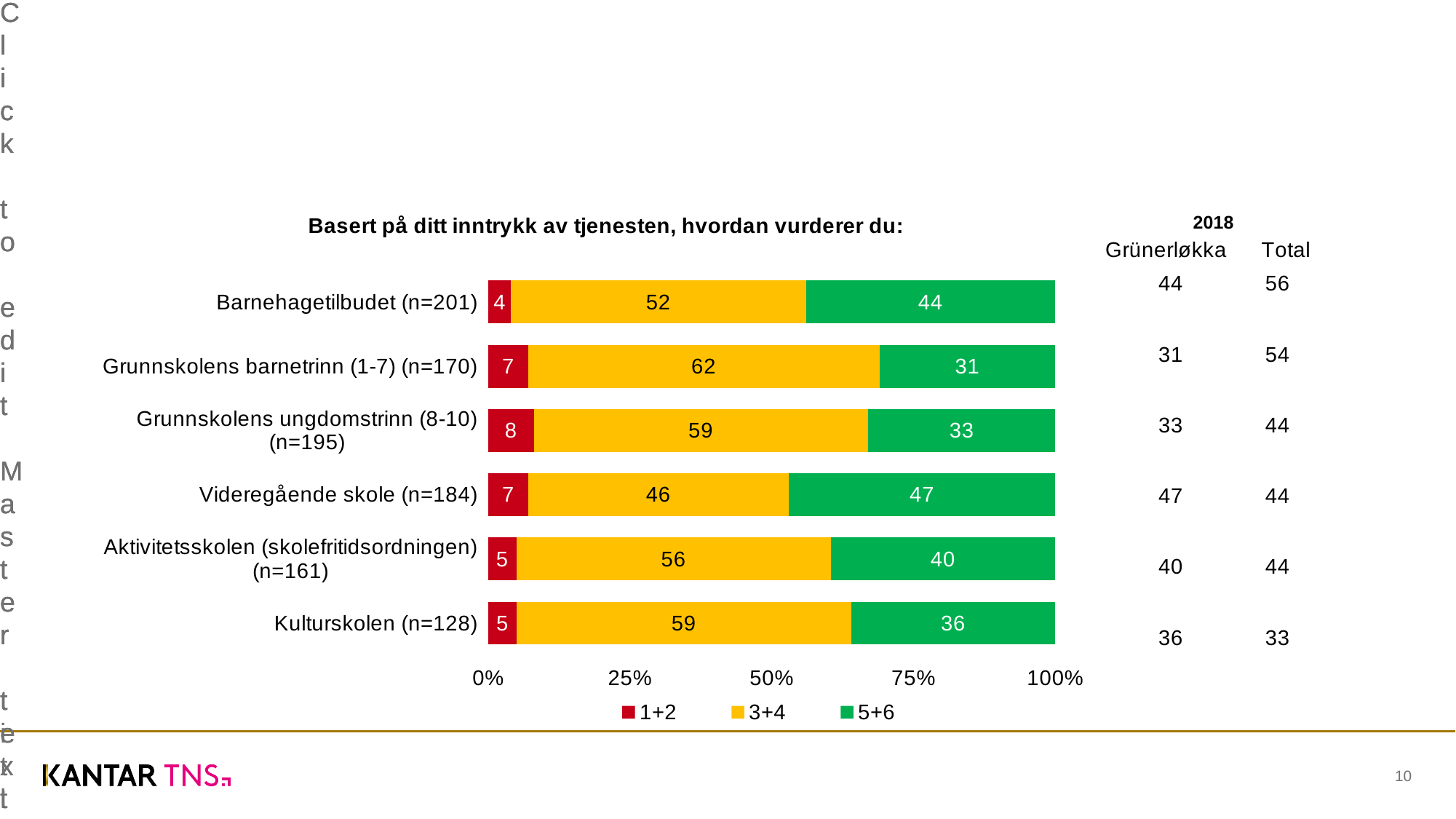
Which is larger: the 5+6 value for Grunnskolens barnetrinn (1-7) (n=170) or for Aktivitetsskolen (skolefritidsordningen) (n=161)? Aktivitetsskolen (skolefritidsordningen) (n=161) How many categories are shown in the chart? 6 What is the value of the 5+6 series for Videregående skole (n=184)? 47 Which category has the highest value for the 3+4 series? Grunnskolens barnetrinn (1-7) (n=170) What is the value of the 1+2 series for Grunnskolens ungdomstrinn (8-10) (n=195)? 8 Which category has the lowest value for the 1+2 series? Barnehagetilbudet (n=201) What is the difference between the 5+6 values for Barnehagetilbudet (n=201) and Kulturskolen (n=128)? 8 How many series does the legend list? 3 What is the value of the 3+4 series for Barnehagetilbudet (n=201)? 52 What kind of chart is shown on the slide? Stacked bar chart What is the title of the chart? Basert på ditt inntrykk av tjenesten, hvordan vurderer du: What is the total of the stacked bar for Kulturskolen (n=128)? 100